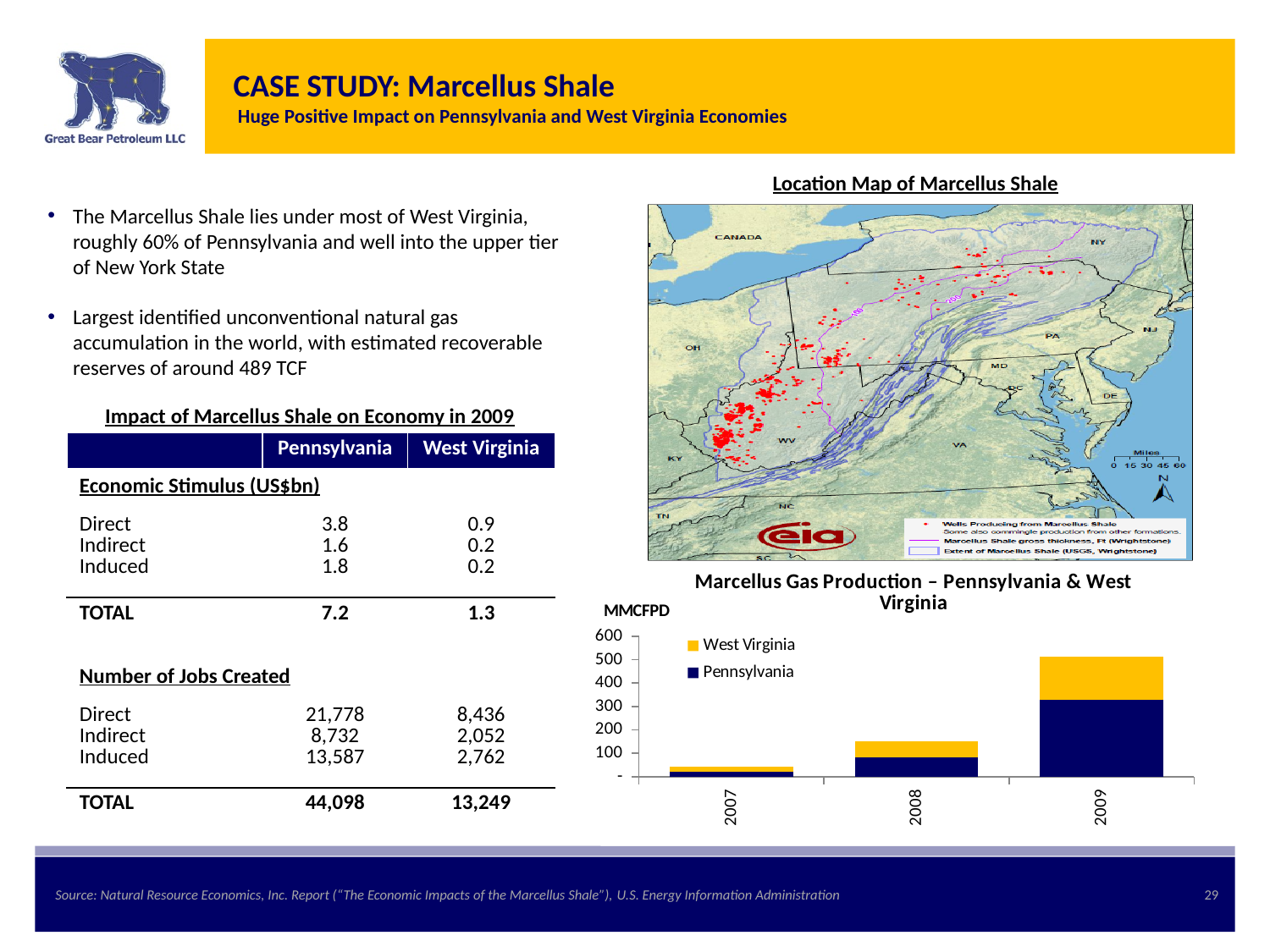
Which year has the highest total production in the Marcellus Gas Production chart? 2009 How many series does the legend of the Marcellus Gas Production chart list? 2 What unit is shown on the y axis of the Marcellus Gas Production chart? MMCFPD How many years are shown on the x axis of the Marcellus Gas Production chart? 3 In the Marcellus Gas Production chart, is the total value for 2008 greater or less than 100? greater In the Marcellus Gas Production chart, do total production values rise or fall from 2007 to 2009? Rise Which year has the lowest total production in the Marcellus Gas Production chart? 2007 In the Marcellus Gas Production chart, which year has the larger total production, 2008 or 2009? 2009 In the Marcellus Gas Production chart, is the total value for 2009 greater or less than 400? greater In the Marcellus Gas Production chart, is the Pennsylvania value for 2009 greater or less than 200? greater What kind of chart is the 'Marcellus Gas Production – Pennsylvania & West Virginia' chart? Stacked bar chart